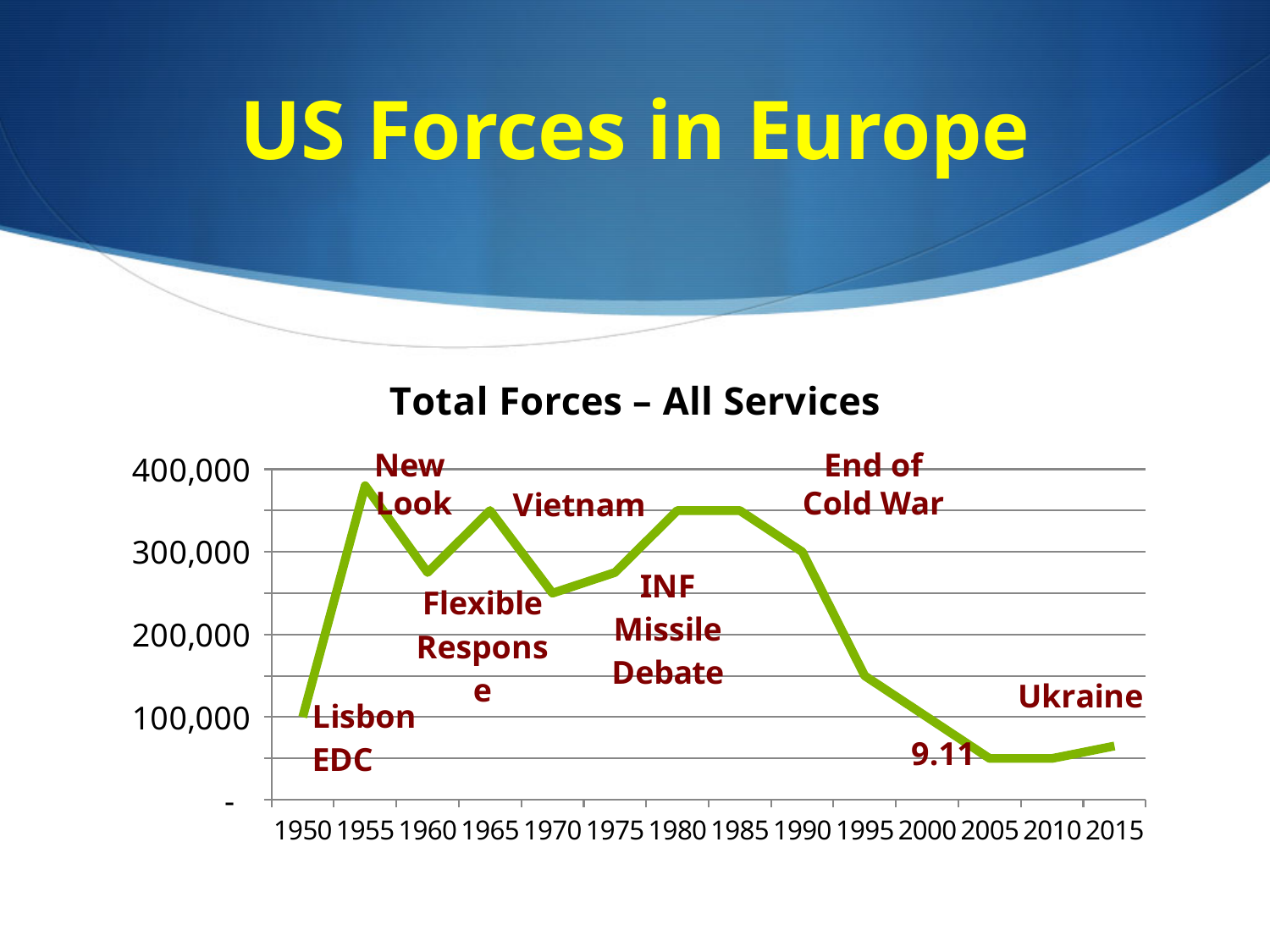
How many years are labelled along the x axis? 14 Is the value for 1980 greater or less than 300,000? greater In which year does the line reach its highest value? 1955 What is the title of the chart? Total Forces – All Services Is the value for 1995 greater or less than 200,000? less Do the values rise or fall between 1985 and 2005? fall Is the value for 1970 greater or less than 300,000? less Which year has the larger value, 1985 or 1995? 1985 Which year has the larger value, 1955 or 1960? 1955 What kind of chart is shown on the slide? line chart